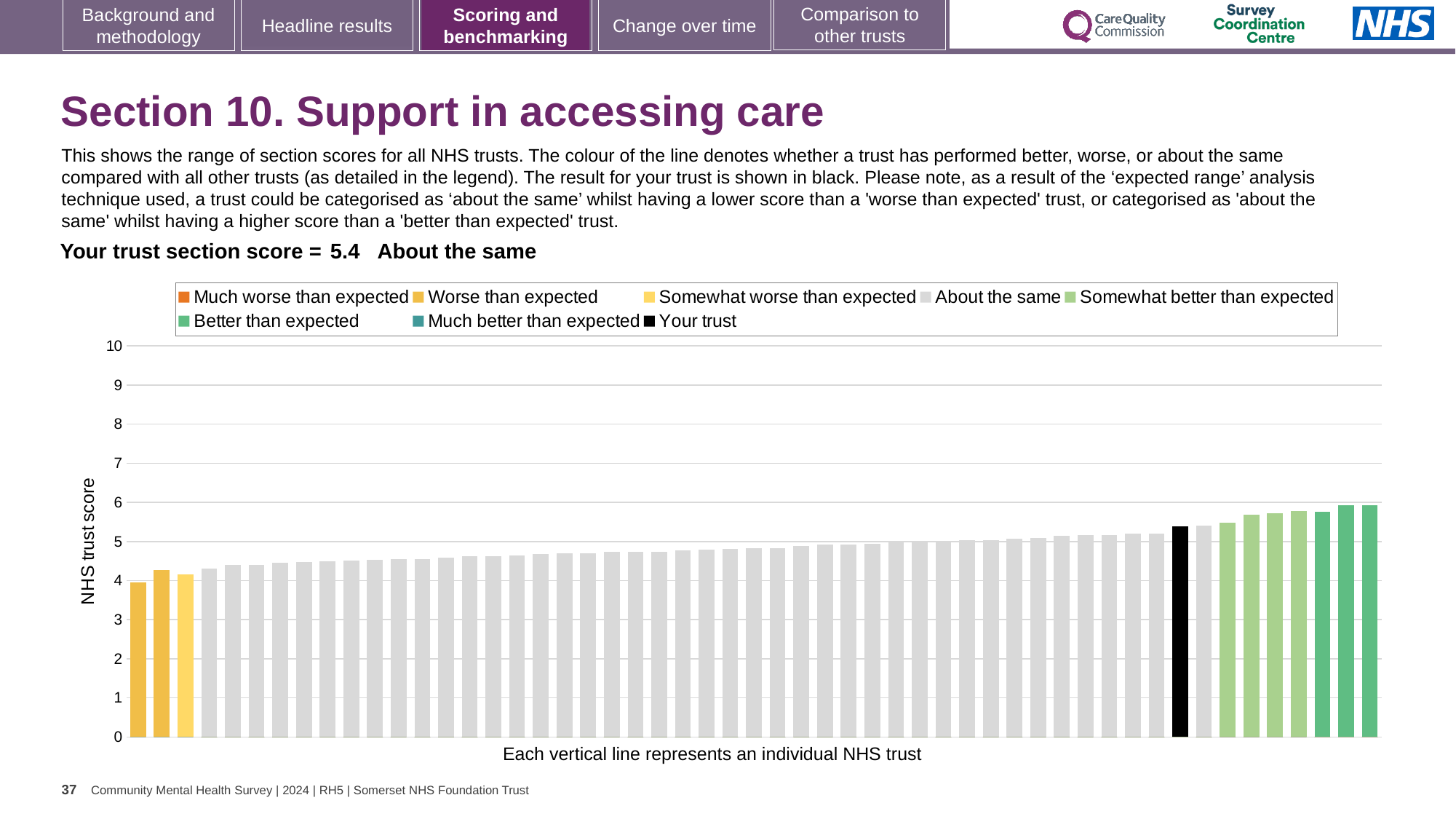
How many entries does the chart legend list? 8 Is the value for the rightmost bar greater or less than 7? less What is the section score for your trust shown on the slide? 5.4 Do the bar values rise or fall from left to right along the x axis? rise Which is larger, the value for your trust (the black bar) or the value for the leftmost bar? your trust (the black bar) Is the value for the leftmost bar greater or less than 5? less Is the value for the rightmost bar greater or less than 5? greater According to the legend, what colour represents 'Your trust'? black What is the label on the vertical axis of the chart? NHS trust score How is your trust's section score categorised compared with other trusts? About the same What kind of chart is shown on the slide? bar chart